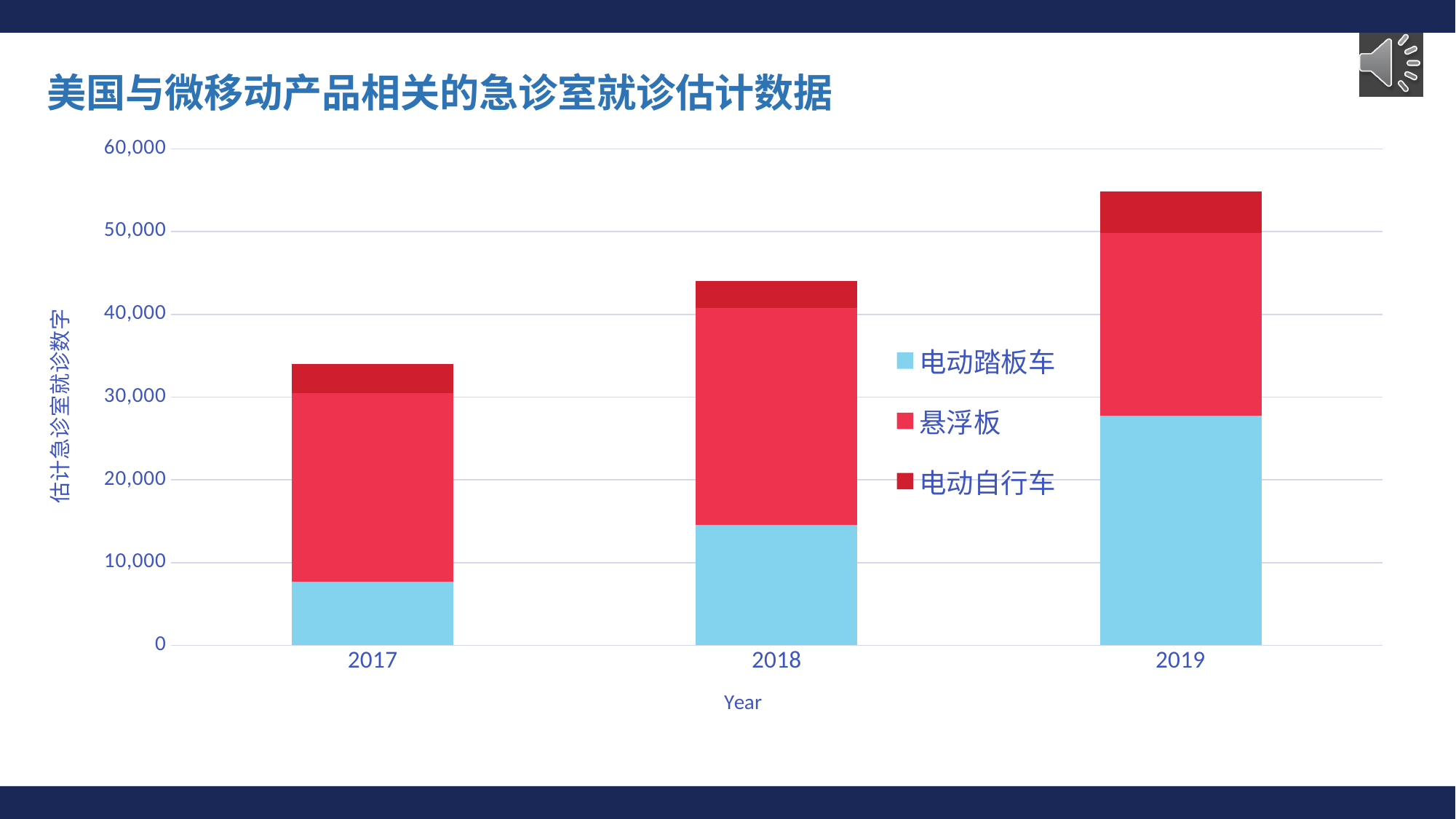
Which year has the lowest total stacked bar? 2017 Is the 电动踏板车 segment for 2019 greater or less than 20,000? greater Is the 电动踏板车 segment for 2017 greater or less than 10,000? less Which series is shown in light blue in the legend? 电动踏板车 Which year has the highest total stacked bar? 2019 Do the total bar heights rise or fall from 2017 to 2019? rise Is the total stacked bar for 2018 greater or less than 50,000? less What kind of chart is shown on the slide? bar chart How many years are shown on the x axis of the chart? 3 How many series does the chart's legend list? 3